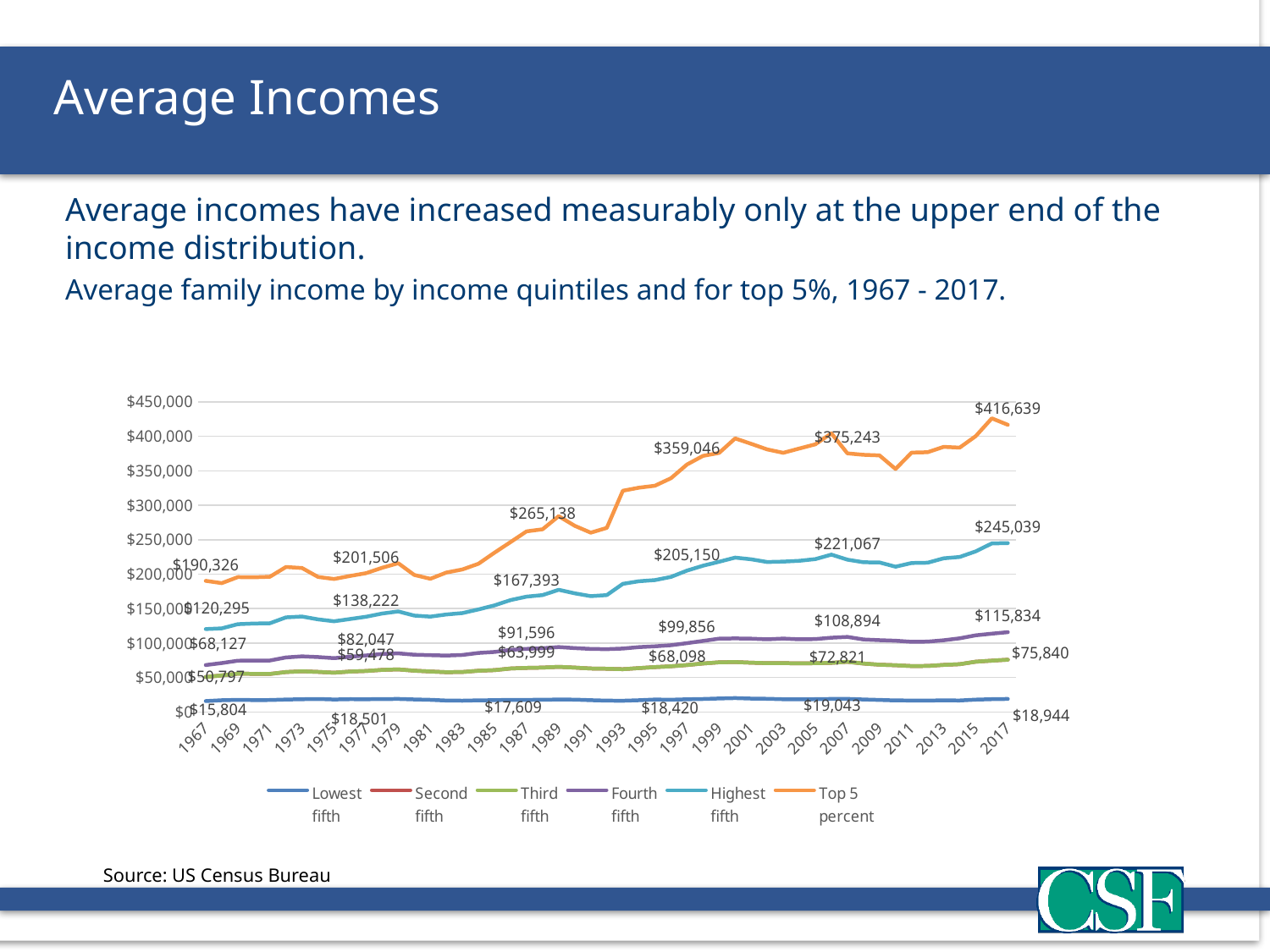
What is the average income for the Top 5 percent in 2017? $416,639 In 2017, which is larger: the Highest fifth or the Fourth fifth average income? Highest fifth By how much did the Top 5 percent average income increase from 1967 ($190,326) to 2017 ($416,639)? $226,313 Which series has the highest value in 2017? Top 5 percent What is the average income for the Lowest fifth in 1967? $15,804 What is the source cited for the chart data? US Census Bureau How many series does the legend list? 6 What kind of chart is shown on the slide? line chart What is the average income for the Highest fifth in 2017? $245,039 What is the average income for the Fourth fifth in 2017? $115,834 Is the Top 5 percent value in 2011 greater or less than $400,000? less What is the average income for the Third fifth in 2017? $75,840